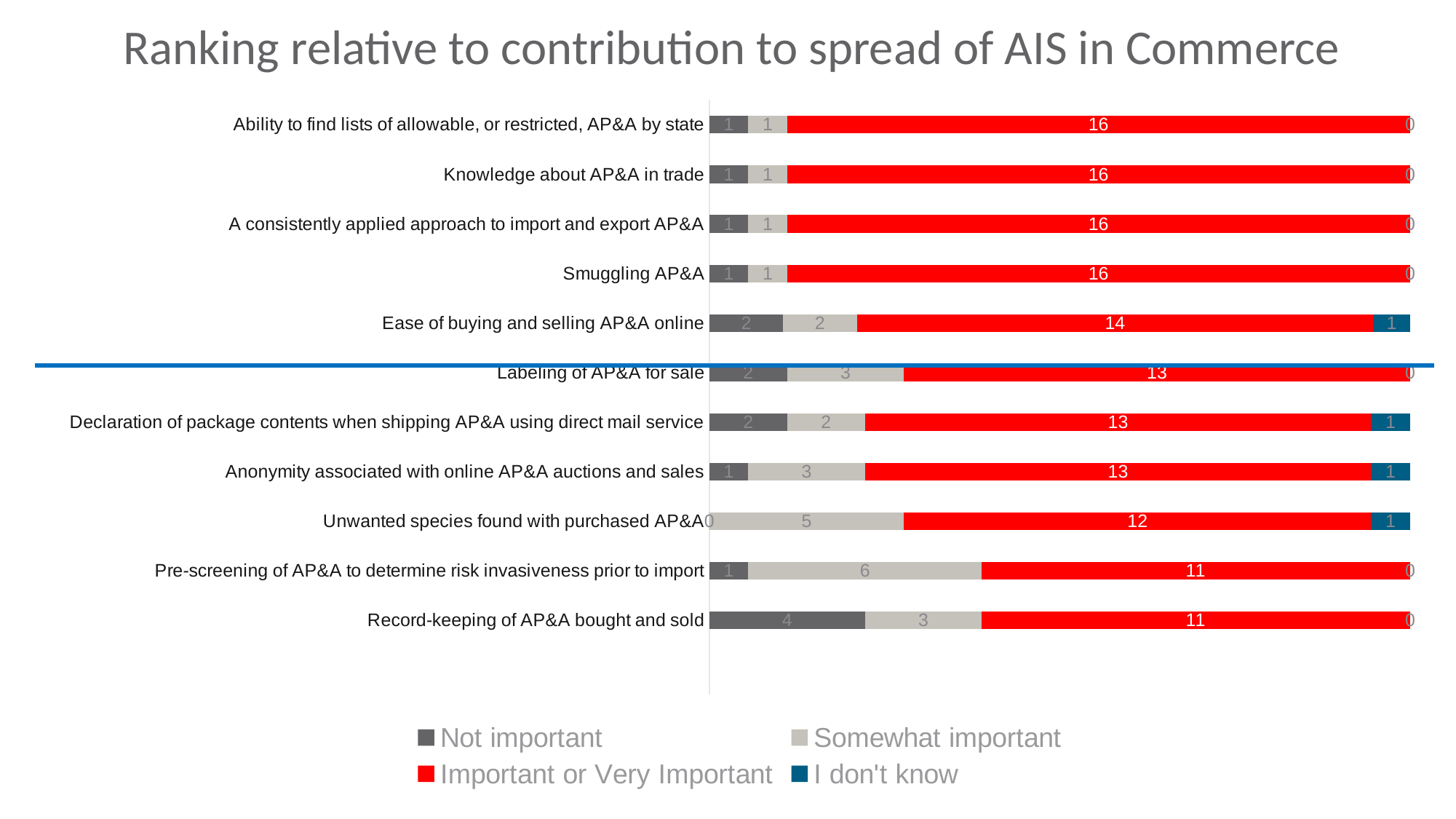
What is the 'Somewhat important' value for 'Pre-screening of AP&A to determine risk invasiveness prior to import'? 6 Which category has the highest 'Somewhat important' value? Pre-screening of AP&A to determine risk invasiveness prior to import How many categories are plotted in the chart? 11 How many series does the legend list? 4 Which is larger: the 'Important or Very Important' value for 'Ease of buying and selling AP&A online' or for 'Labeling of AP&A for sale'? Ease of buying and selling AP&A online What is the 'Not important' value for 'Record-keeping of AP&A bought and sold'? 4 Which category has the highest 'Not important' value? Record-keeping of AP&A bought and sold What is the total of the stacked bar for 'Ease of buying and selling AP&A online'? 19 What is the 'Important or Very Important' value for 'Smuggling AP&A'? 16 What is the 'I don't know' value for 'Ease of buying and selling AP&A online'? 1 What type of chart is shown on the slide? Stacked bar chart What is the difference between the 'Important or Very Important' values for 'Knowledge about AP&A in trade' and 'Unwanted species found with purchased AP&A'? 4